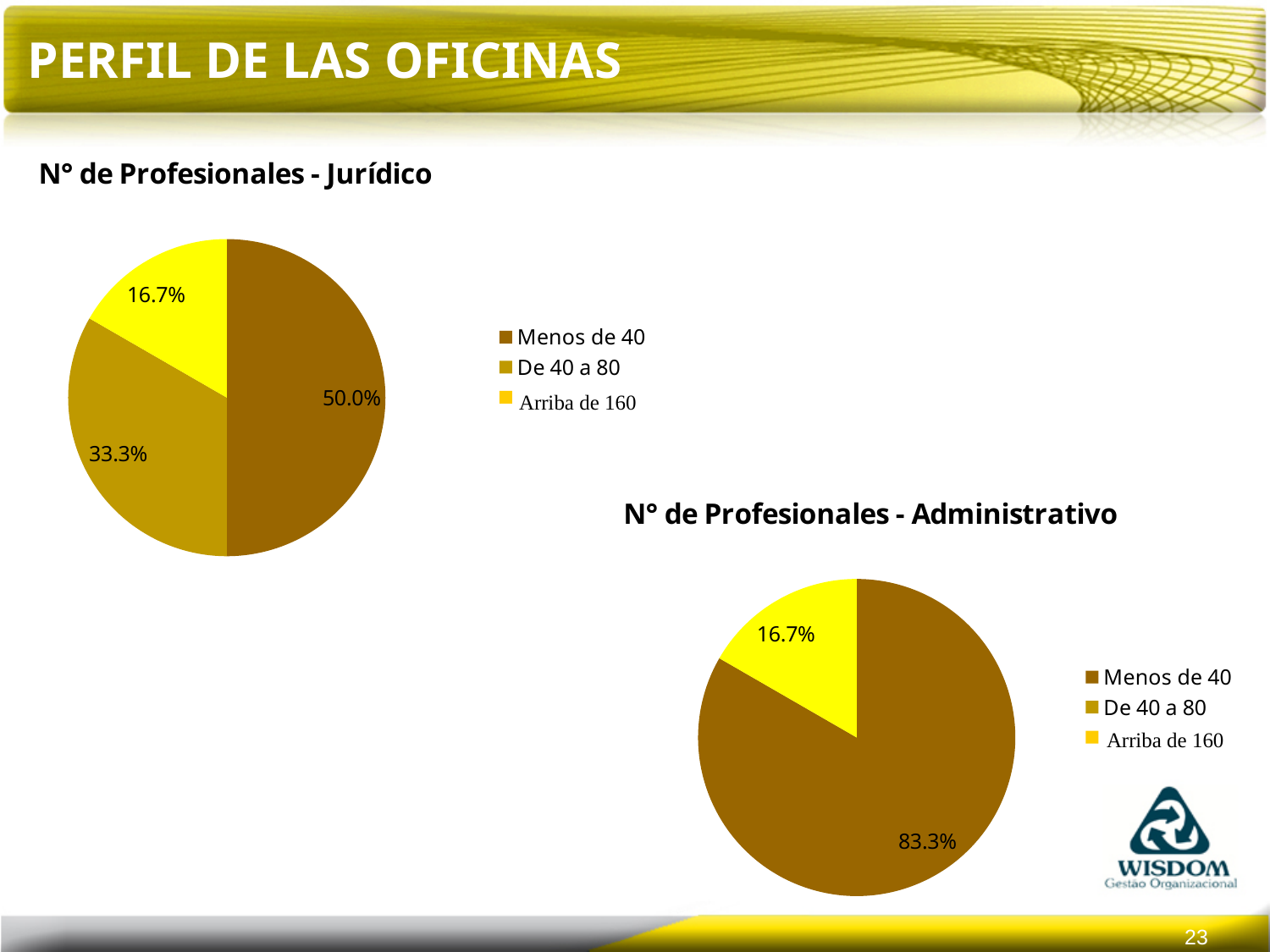
In the 'N° de Profesionales - Jurídico' chart, what share does 'De 40 a 80' have? 33.3% In the 'N° de Profesionales - Administrativo' chart, what share does 'Menos de 40' have? 83.3% What type of chart is 'N° de Profesionales - Jurídico'? Pie chart In the 'N° de Profesionales - Administrativo' chart, which category has the largest slice? Menos de 40 In the 'N° de Profesionales - Jurídico' chart, what share does 'Arriba de 160' have? 16.7% In the 'N° de Profesionales - Jurídico' chart, what is the difference between the 'Menos de 40' and 'De 40 a 80' shares? 16.7% In the 'N° de Profesionales - Administrativo' chart, what share does 'Arriba de 160' have? 16.7% In the 'N° de Profesionales - Jurídico' chart, what share does 'Menos de 40' have? 50.0% In the 'N° de Profesionales - Jurídico' chart, which category has the smallest slice? Arriba de 160 In the 'N° de Profesionales - Administrativo' chart, what is the difference between the 'Menos de 40' and 'Arriba de 160' shares? 66.6% How many entries does the legend of the 'N° de Profesionales - Administrativo' chart list? 3 In the 'N° de Profesionales - Jurídico' chart, which category has the largest slice? Menos de 40